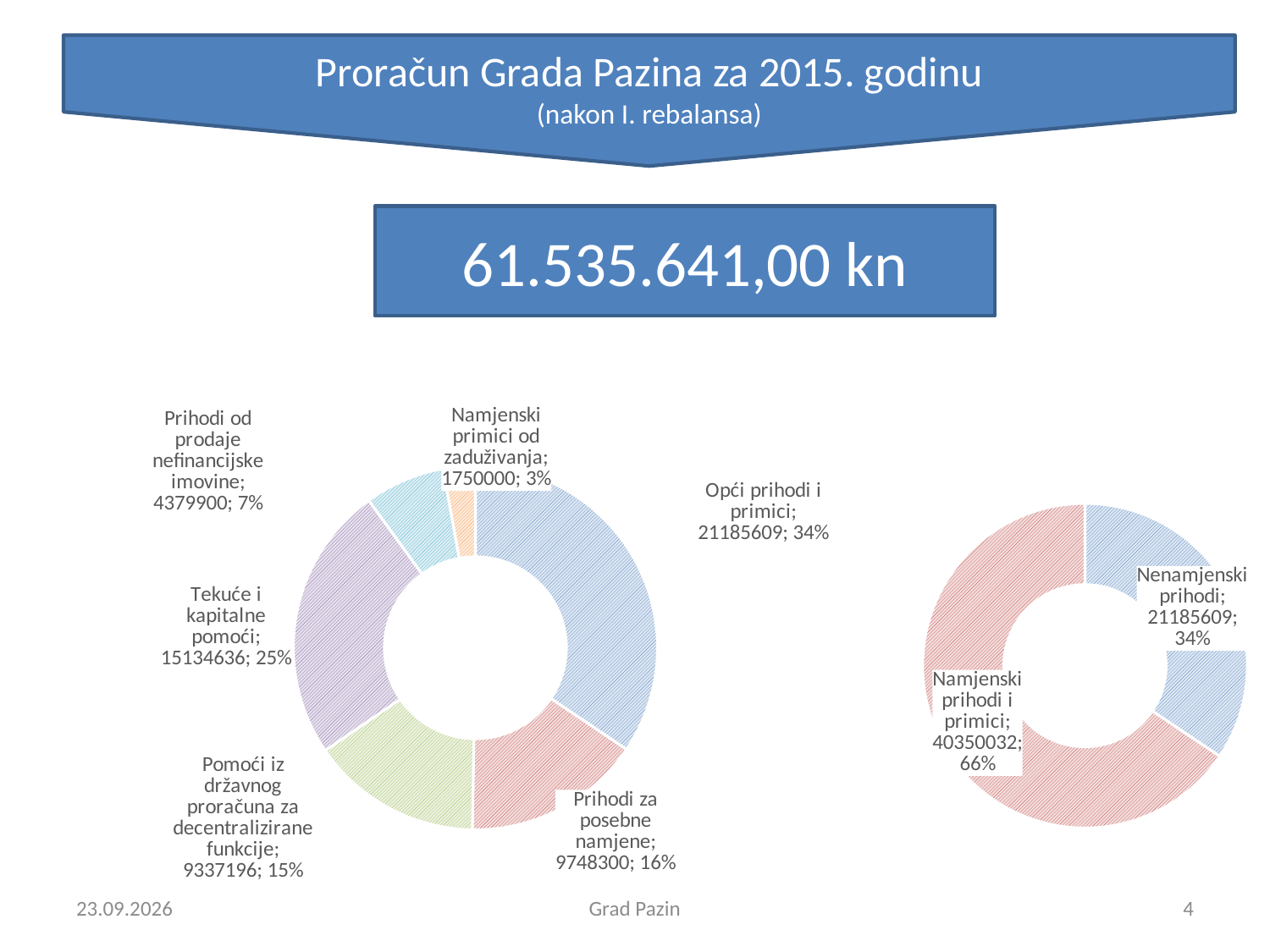
On the left doughnut chart, what value is shown for Opći prihodi i primici? 21185609 On the right doughnut chart, what value is shown for Namjenski prihodi i primici? 40350032 On the left doughnut chart, what percentage share does Tekuće i kapitalne pomoći have? 25% On the right doughnut chart, what percentage share does Nenamjenski prihodi have? 34% On the left doughnut chart, what is the difference between the values for Prihodi za posebne namjene and Pomoći iz državnog proračuna za decentralizirane funkcije? 411104 On the left doughnut chart, which category has the smallest value? Namjenski primici od zaduživanja On the left doughnut chart, which category has the largest value? Opći prihodi i primici On the left doughnut chart, which is larger: Prihodi od prodaje nefinancijske imovine or Namjenski primici od zaduživanja? Prihodi od prodaje nefinancijske imovine How many categories are shown on the right doughnut chart? 2 What type of chart is the chart on the right of the slide? Doughnut chart How many categories are shown on the left doughnut chart? 6 On the right doughnut chart, what is the difference between the values for Namjenski prihodi i primici and Nenamjenski prihodi? 19164423